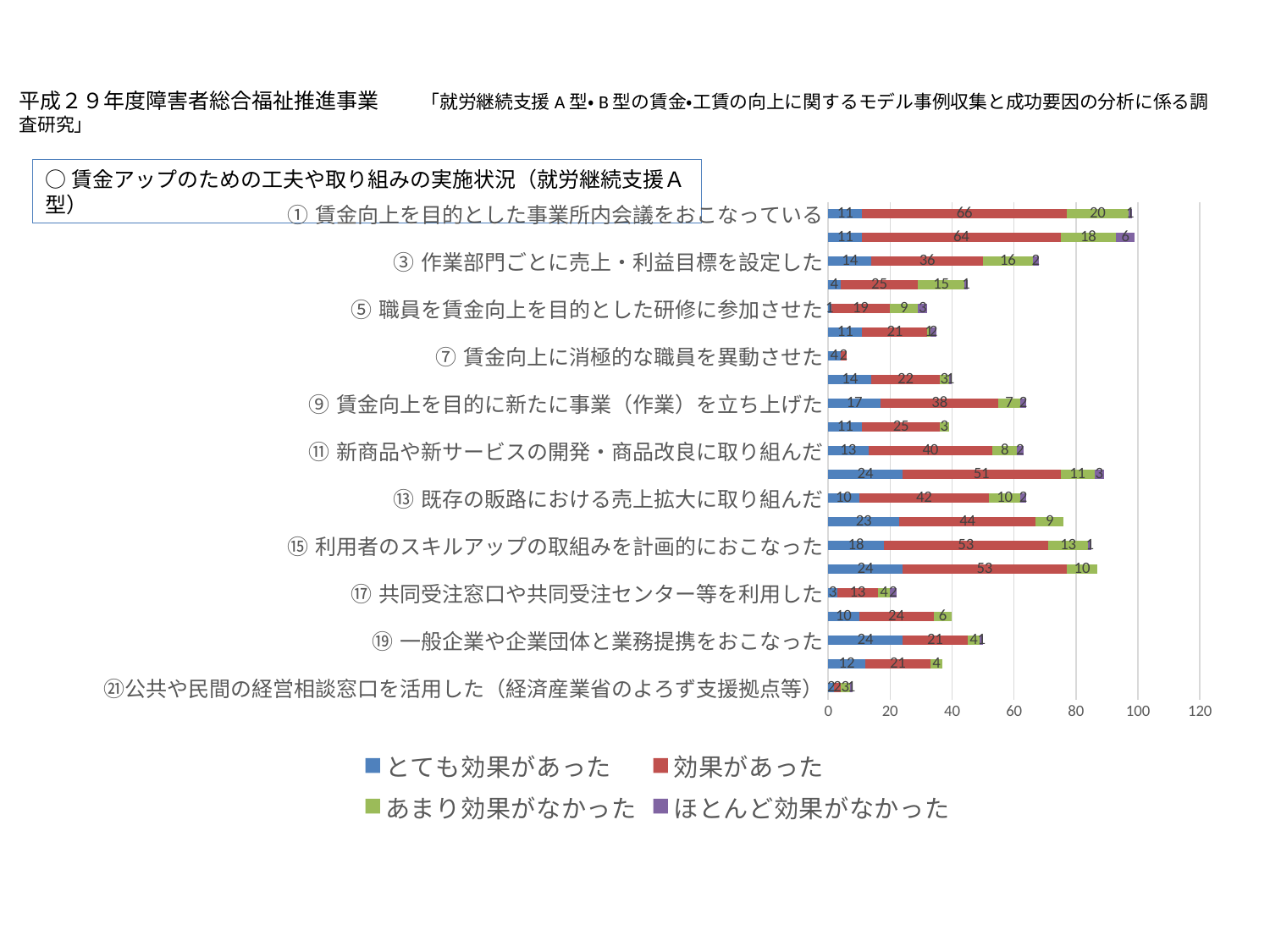
What is the value of 効果があった for ⑮ 利用者のスキルアップの取組みを計画的におこなった? 53 What is the value of とても効果があった for ⑲ 一般企業や企業団体と業務提携をおこなった? 24 What is the total of the stacked bar for ① 賃金向上を目的とした事業所内会議をおこなっている? 98 Which has a larger 効果があった value: ③ 作業部門ごとに売上・利益目標を設定した or ⑤ 職員を賃金向上を目的とした研修に参加させた? ③ 作業部門ごとに売上・利益目標を設定した How many series does the legend list? 4 What is the total of the stacked bar for ⑨ 賃金向上を目的に新たに事業（作業）を立ち上げた? 64 Is the total bar length for ⑰ 共同受注窓口や共同受注センター等を利用した greater or less than 40? less What is the value of 効果があった for ① 賃金向上を目的とした事業所内会議をおこなっている? 66 Which series is shown in blue in the legend? とても効果があった What is the difference between the 効果があった values for ⑪ 新商品や新サービスの開発・商品改良に取り組んだ and ⑬ 既存の販路における売上拡大に取り組んだ? 2 What is the value of あまり効果がなかった for ③ 作業部門ごとに売上・利益目標を設定した? 16 What kind of chart is shown on the slide? Stacked bar chart